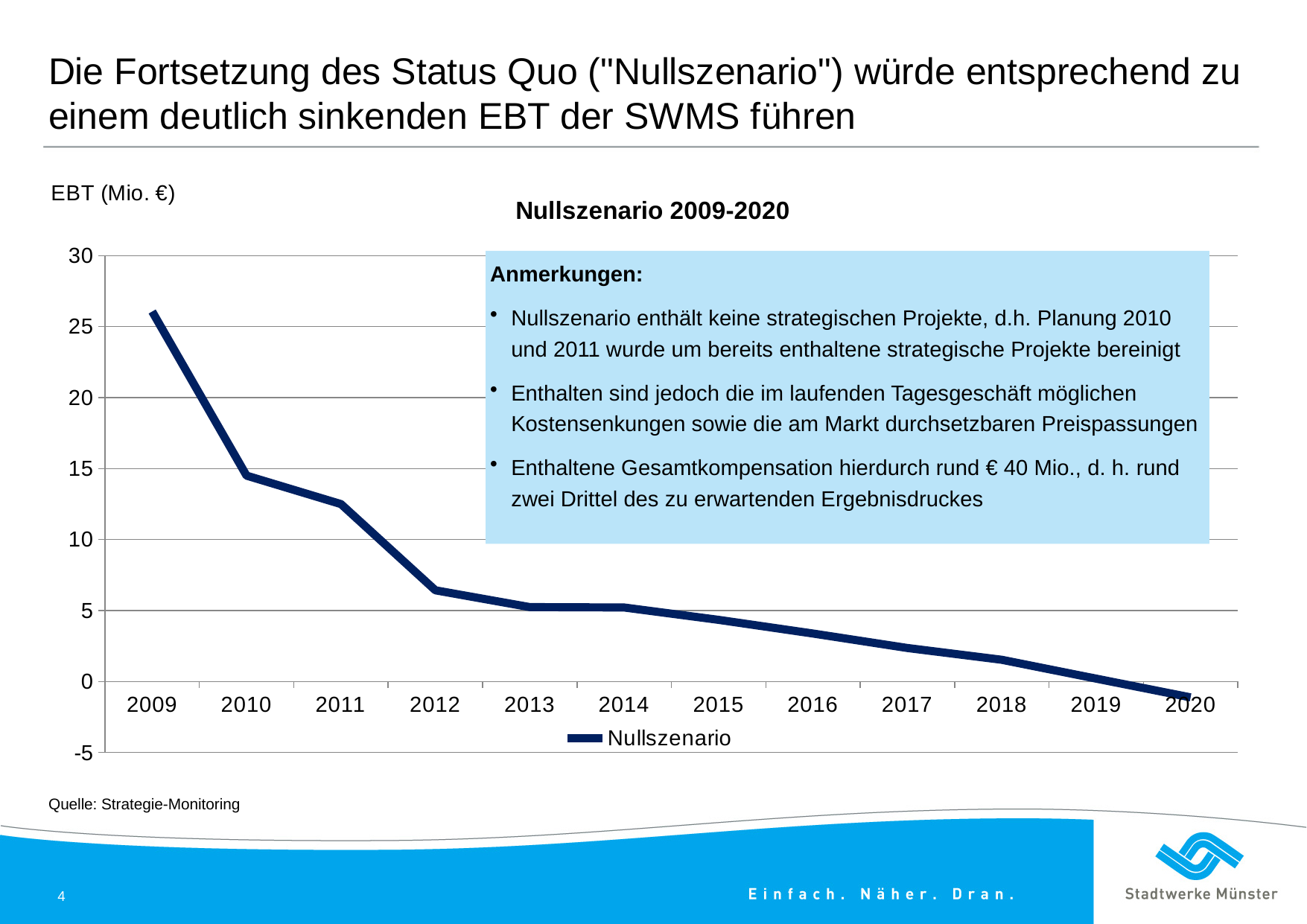
How many years are plotted on the x axis of the chart? 12 How many series does the chart legend list? 1 Do the EBT values rise or fall from 2009 to 2020? fall What kind of chart is shown on the slide? line chart Is the value for 2009 greater or less than 25? greater What is the title of the chart? Nullszenario 2009-2020 Is the value for 2012 greater or less than 5? greater Which year has the larger EBT value, 2011 or 2016? 2011 In which year is the EBT value lowest? 2020 In which year is the EBT value highest? 2009 Is the value for 2020 greater or less than 0? less